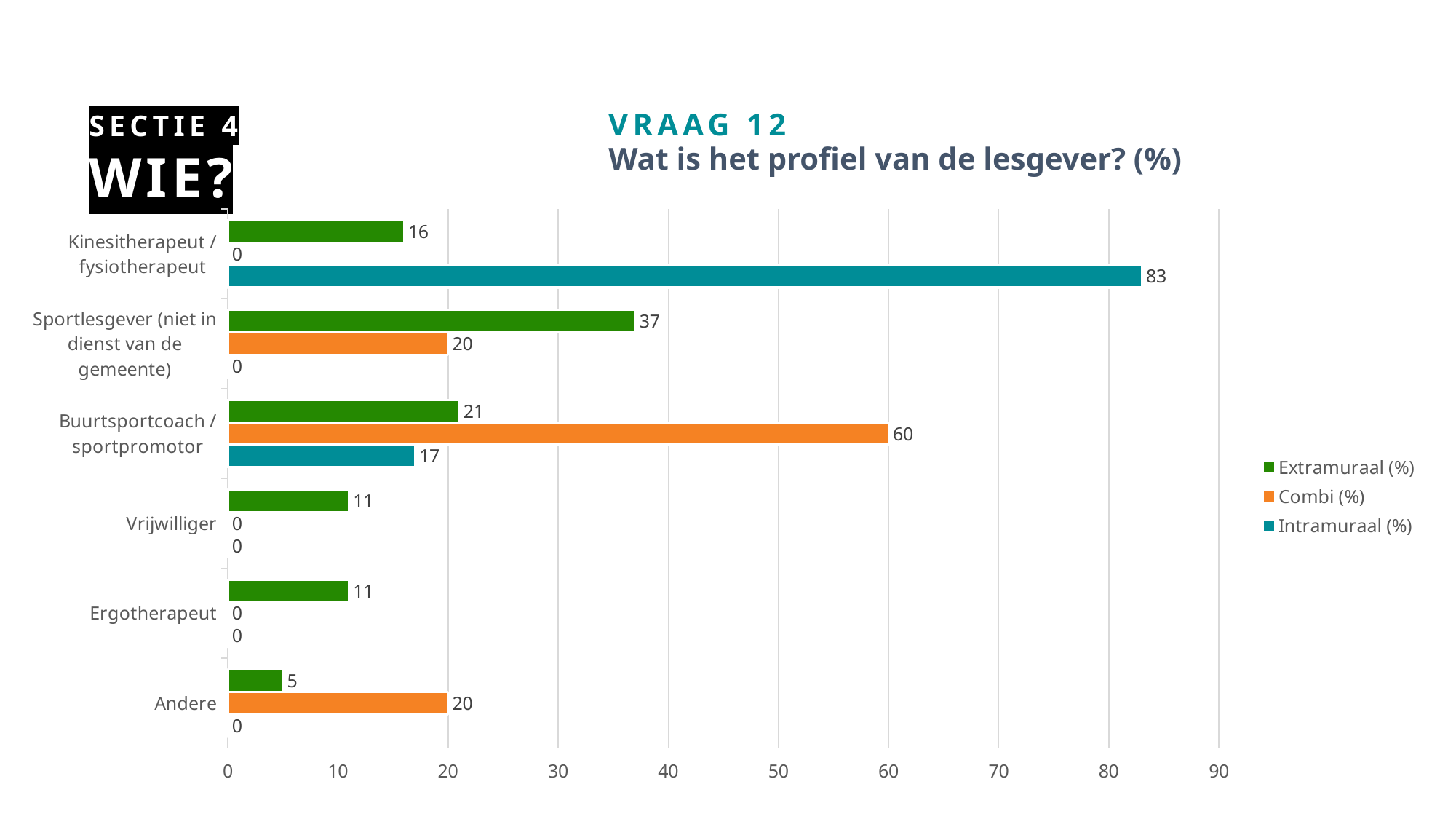
Which is larger for Buurtsportcoach / sportpromotor: the Extramuraal (%) value or the Combi (%) value? Combi (%) What is the Combi (%) value for Andere? 20 What is the Extramuraal (%) value for Sportlesgever (niet in dienst van de gemeente)? 37 What is the Combi (%) value for Buurtsportcoach / sportpromotor? 60 Which category has the lowest Extramuraal (%) value? Andere What is the difference between the Intramuraal (%) value for Kinesitherapeut / fysiotherapeut and the Intramuraal (%) value for Buurtsportcoach / sportpromotor? 66 What is the Intramuraal (%) value for Kinesitherapeut / fysiotherapeut? 83 How many series does the legend list? 3 What is the title of the chart? Wat is het profiel van de lesgever? (%) What kind of chart is shown on the slide? Bar chart Which category has the highest Extramuraal (%) value? Sportlesgever (niet in dienst van de gemeente) How many categories are shown on the chart? 6